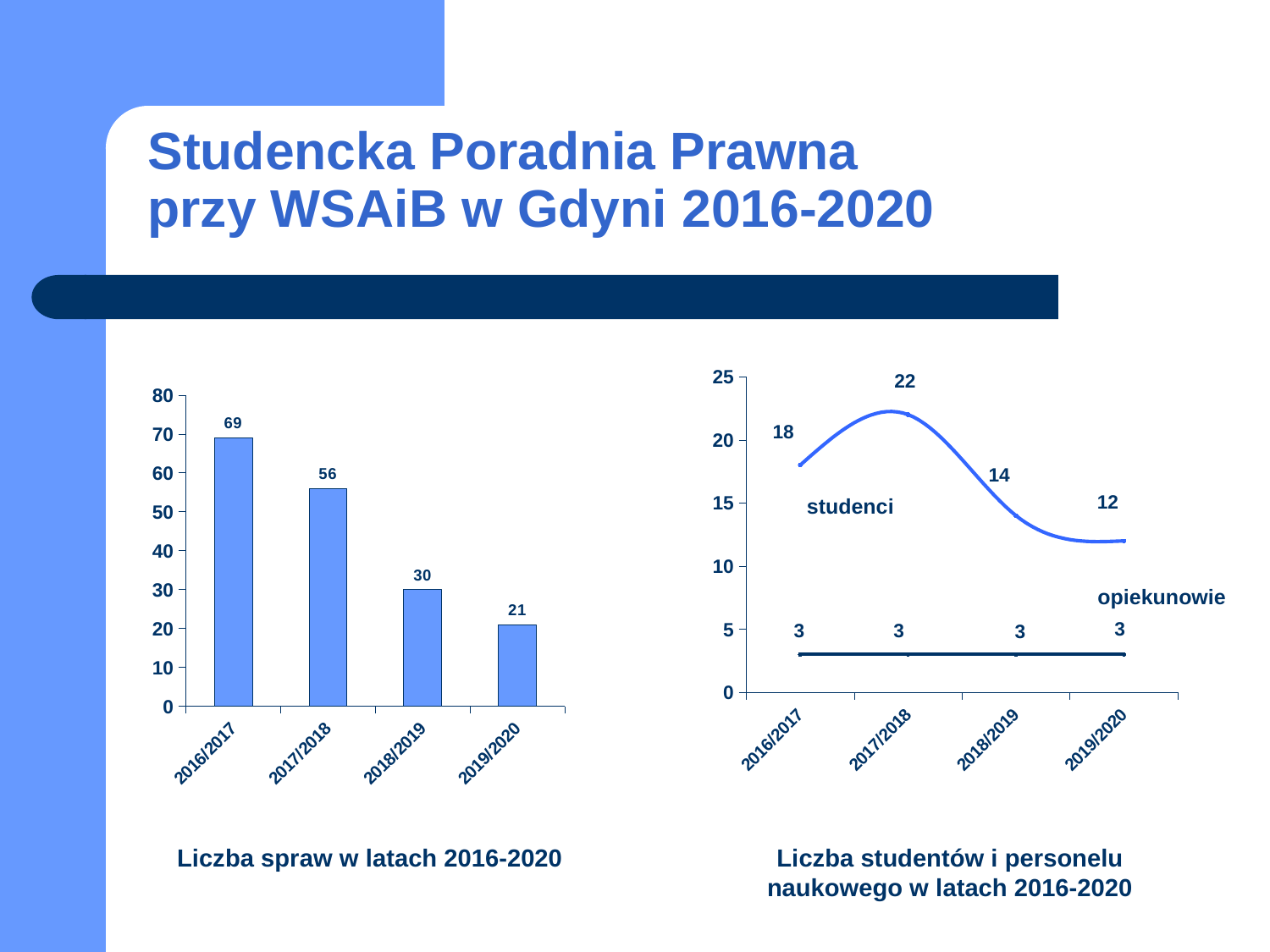
In the left chart (Liczba spraw w latach 2016-2020), what is the value for 2016/2017? 69 What kind of chart is the right chart (Liczba studentów i personelu naukowego w latach 2016-2020)? line chart In the left chart (Liczba spraw w latach 2016-2020), do the values rise or fall from 2016/2017 to 2019/2020? fall In the left chart (Liczba spraw w latach 2016-2020), what is the value for 2019/2020? 21 In the left chart (Liczba spraw w latach 2016-2020), what is the difference between the values for 2017/2018 and 2018/2019? 26 What kind of chart is the left chart (Liczba spraw w latach 2016-2020)? bar chart In the right chart (Liczba studentów i personelu naukowego w latach 2016-2020), what is the difference between studenci and opiekunowie in 2016/2017? 15 In the right chart (Liczba studentów i personelu naukowego w latach 2016-2020), what is the value for opiekunowie in 2019/2020? 3 In the left chart (Liczba spraw w latach 2016-2020), which year has the highest value? 2016/2017 In the left chart (Liczba spraw w latach 2016-2020), which year has the lowest value? 2019/2020 In the right chart (Liczba studentów i personelu naukowego w latach 2016-2020), which year has the highest value for studenci? 2017/2018 In the right chart (Liczba studentów i personelu naukowego w latach 2016-2020), what is the value for studenci in 2017/2018? 22